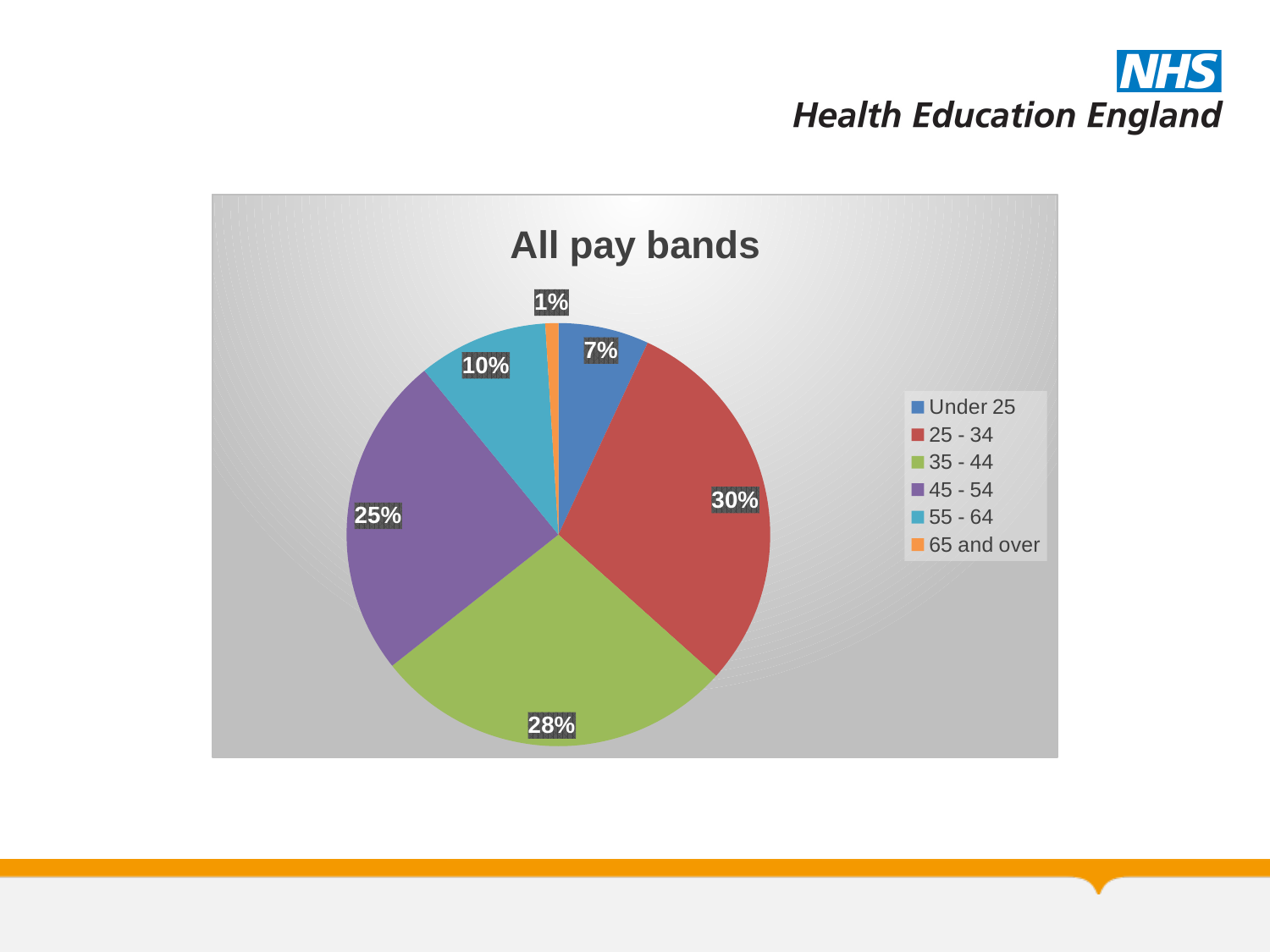
Which has a larger share, 45 - 54 or 35 - 44? 35 - 44 What is the difference in percentage points between the 25 - 34 and 55 - 64 shares? 20 What share of the pie does the Under 25 age group have? 7% What share of the pie does the 25 - 34 age group have? 30% What share of the pie does the 45 - 54 age group have? 25% How many age groups are shown in the pie chart? 6 Which age group has the smallest share of the pie? 65 and over Which age group has the largest share of the pie? 25 - 34 What type of chart is shown on the slide? Pie chart